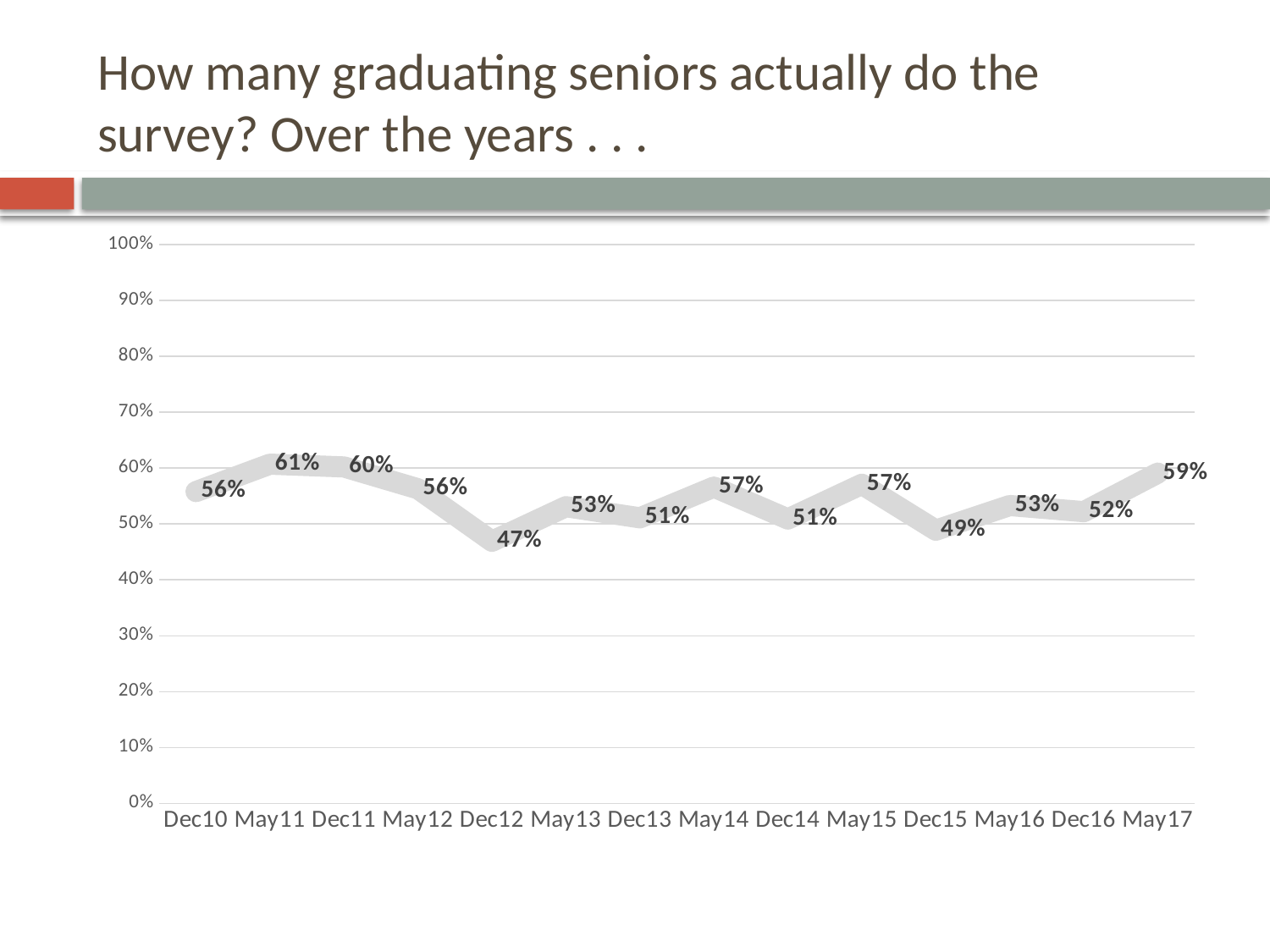
Which period has the lowest value? Dec12 What kind of chart is shown on the slide? line chart What is the value for May11? 61% Which period has the highest value? May11 Which is larger, the value for May14 or the value for Dec14? May14 What is the value for Dec15? 49% What is the value for May17? 59% Is the value for Dec11 greater or less than 50%? greater What is the difference between the values for May11 and Dec12? 14% What is the value for Dec12? 47% How many periods are plotted on the x axis? 14 Does the value rise or fall from Dec16 to May17? rise